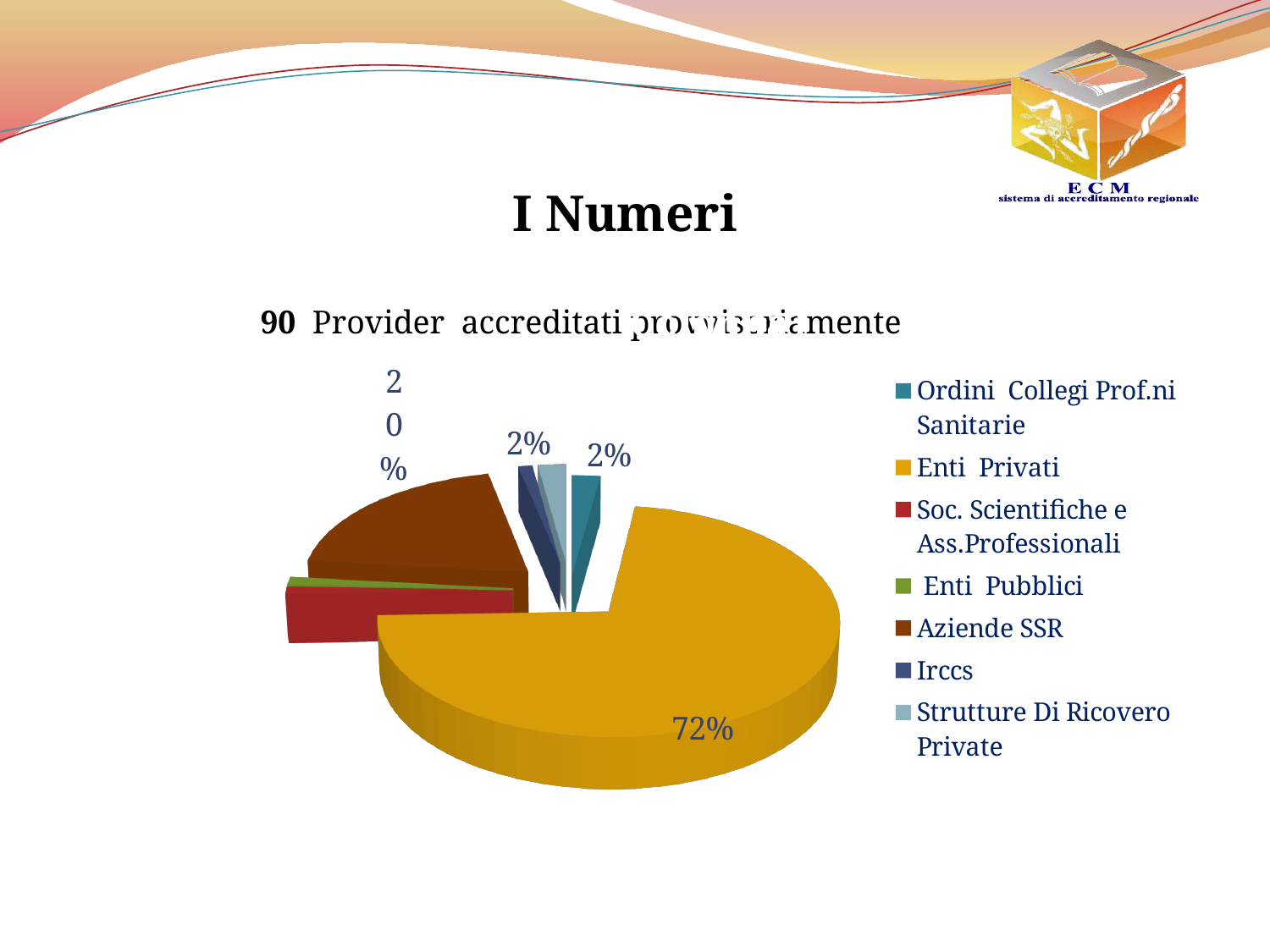
What percentage of the pie is labelled for Aziende SSR? 20% What share of the pie does the Enti Privati slice represent? 72% What is the difference in percentage points between the Enti Privati slice and the Aziende SSR slice? 52 percentage points Which category has the largest slice of the pie? Enti Privati What percentage is labelled for Ordini Collegi Prof.ni Sanitarie? 2% Is the share for Enti Privati greater or less than 50%? greater What percentage of the pie is labelled for Enti Privati? 72% How many categories does the legend of the pie chart list? 7 Which slice is larger, Enti Privati or Aziende SSR? Enti Privati What kind of chart is shown on the slide? Pie chart According to the text above the chart, how many providers are provisionally accredited? 90 What colour is the Enti Privati slice in the pie chart? Gold/yellow